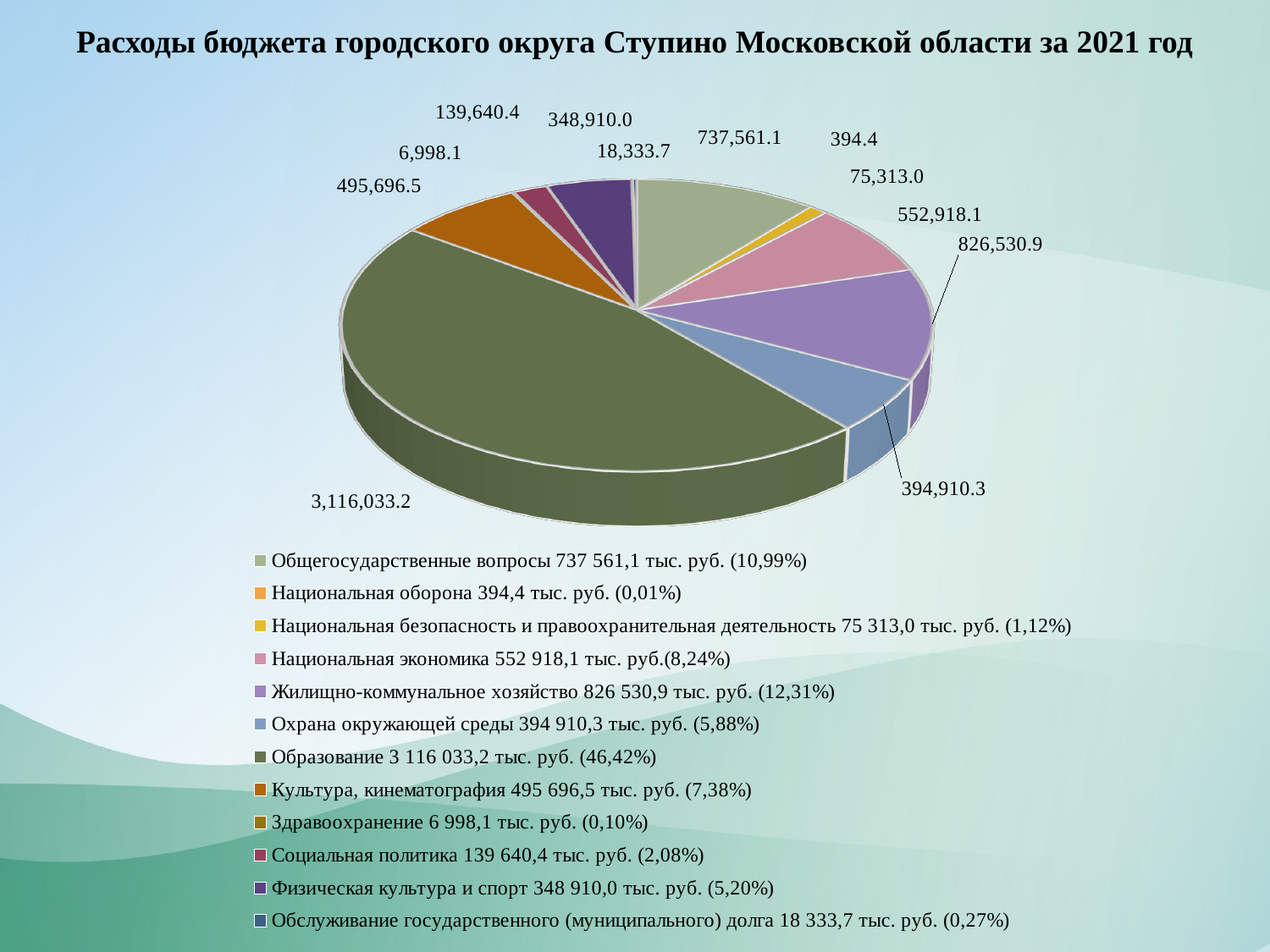
What is the title of the chart? Расходы бюджета городского округа Ступино Московской области за 2021 год What is the value shown for Жилищно-коммунальное хозяйство? 826,530.9 What kind of chart is shown on the slide? Pie chart What is the difference between the values for Жилищно-коммунальное хозяйство and Национальная экономика? 273,612.8 Which category has the smallest value? Национальная оборона According to the legend, what share of the pie does Образование represent? 46,42% Which is larger: the value for Культура, кинематография or the value for Охрана окружающей среды? Культура, кинематография What is the value shown for Национальная оборона? 394.4 How many categories does the pie chart have? 12 Which category has the largest slice of the pie? Образование What is the value shown for Образование? 3,116,033.2 What is the value shown for Физическая культура и спорт? 348,910.0